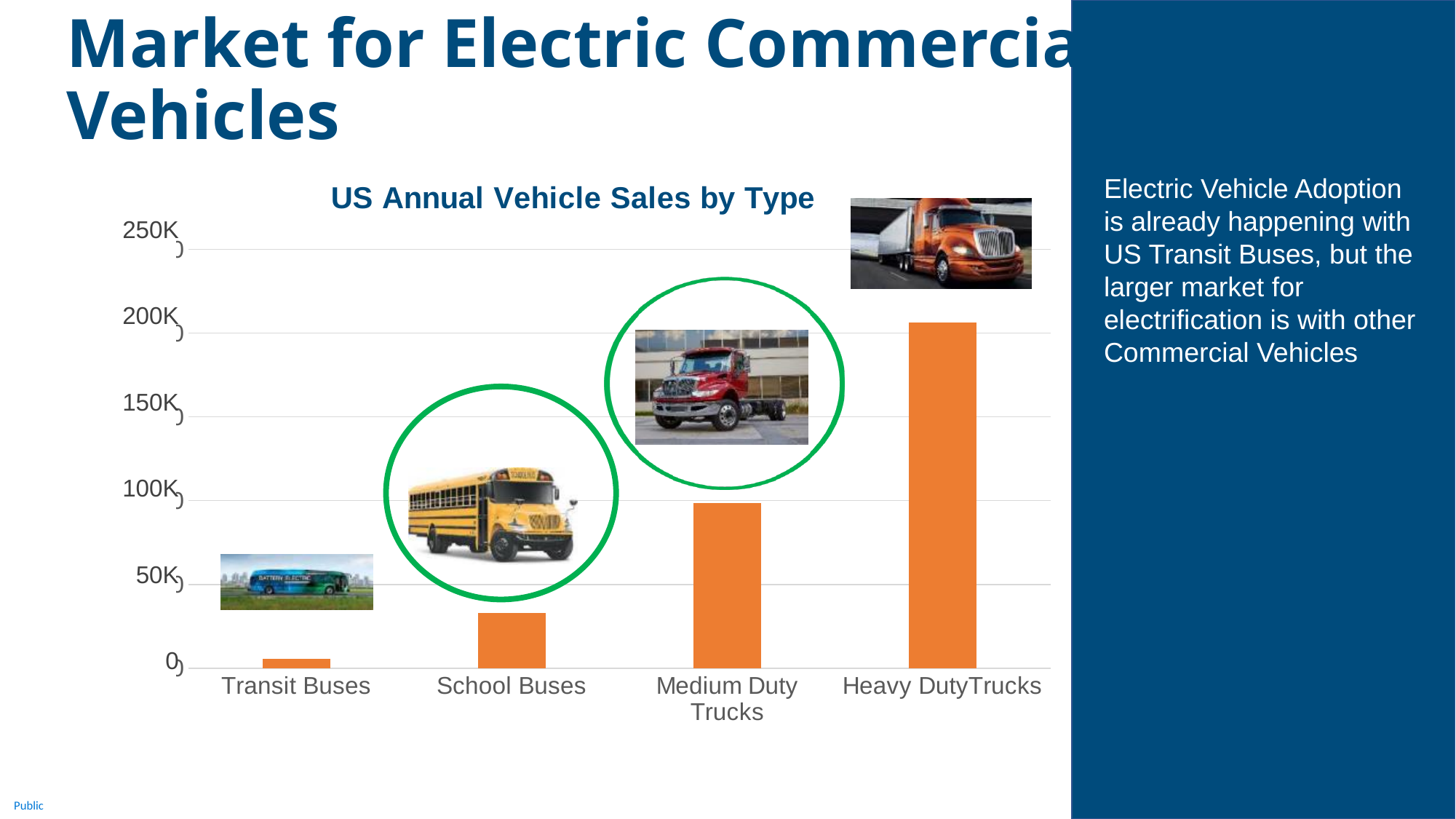
Do the bar values rise or fall moving from left to right across the x axis? rise What is the title of the chart on the slide? US Annual Vehicle Sales by Type Which vehicle type has the lowest annual sales in the chart? Transit Buses What kind of chart is shown on the slide? bar chart Which has higher annual sales, School Buses or Medium Duty Trucks? Medium Duty Trucks How many vehicle type categories are shown on the x axis of the chart? 4 Is the value for Medium Duty Trucks greater or less than 50K? greater Is the value for School Buses greater or less than 50K? less What colour are the bars in the chart? orange Is the value for Heavy Duty Trucks greater or less than 150K? greater Which vehicle type has the highest annual sales in the chart? Heavy Duty Trucks